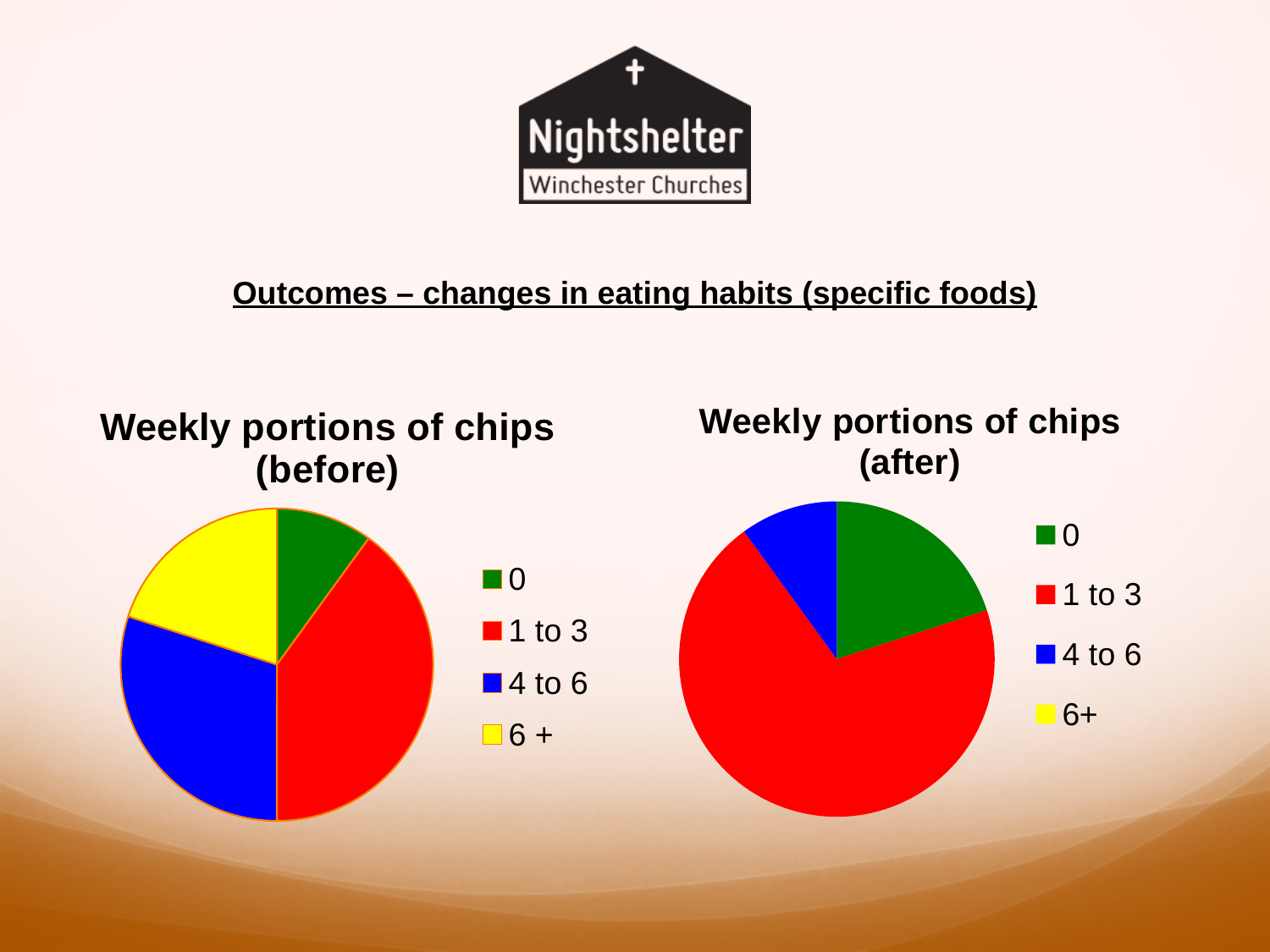
How many slices are visible in the "Weekly portions of chips (after)" pie? 3 In the "Weekly portions of chips (before)" chart, which slice is larger: "1 to 3" or "4 to 6"? 1 to 3 In the "Weekly portions of chips (after)" chart, which category has the largest slice? 1 to 3 In the "Weekly portions of chips (after)" chart, which slice is larger: "0" or "4 to 6"? 0 In the "Weekly portions of chips (before)" chart, which category has the largest slice? 1 to 3 In the "Weekly portions of chips (before)" chart, which category has the smallest slice? 0 In the "Weekly portions of chips (before)" chart, what colour represents the "4 to 6" category? blue What kind of chart is the "Weekly portions of chips (before)" chart? pie chart What kind of chart is the "Weekly portions of chips (after)" chart? pie chart In the "Weekly portions of chips (after)" chart, which legend category has no visible slice in the pie? 6+ How many categories does the legend of the "Weekly portions of chips (before)" chart list? 4 In the "Weekly portions of chips (before)" chart, which slice is larger: "4 to 6" or "6 +"? 4 to 6